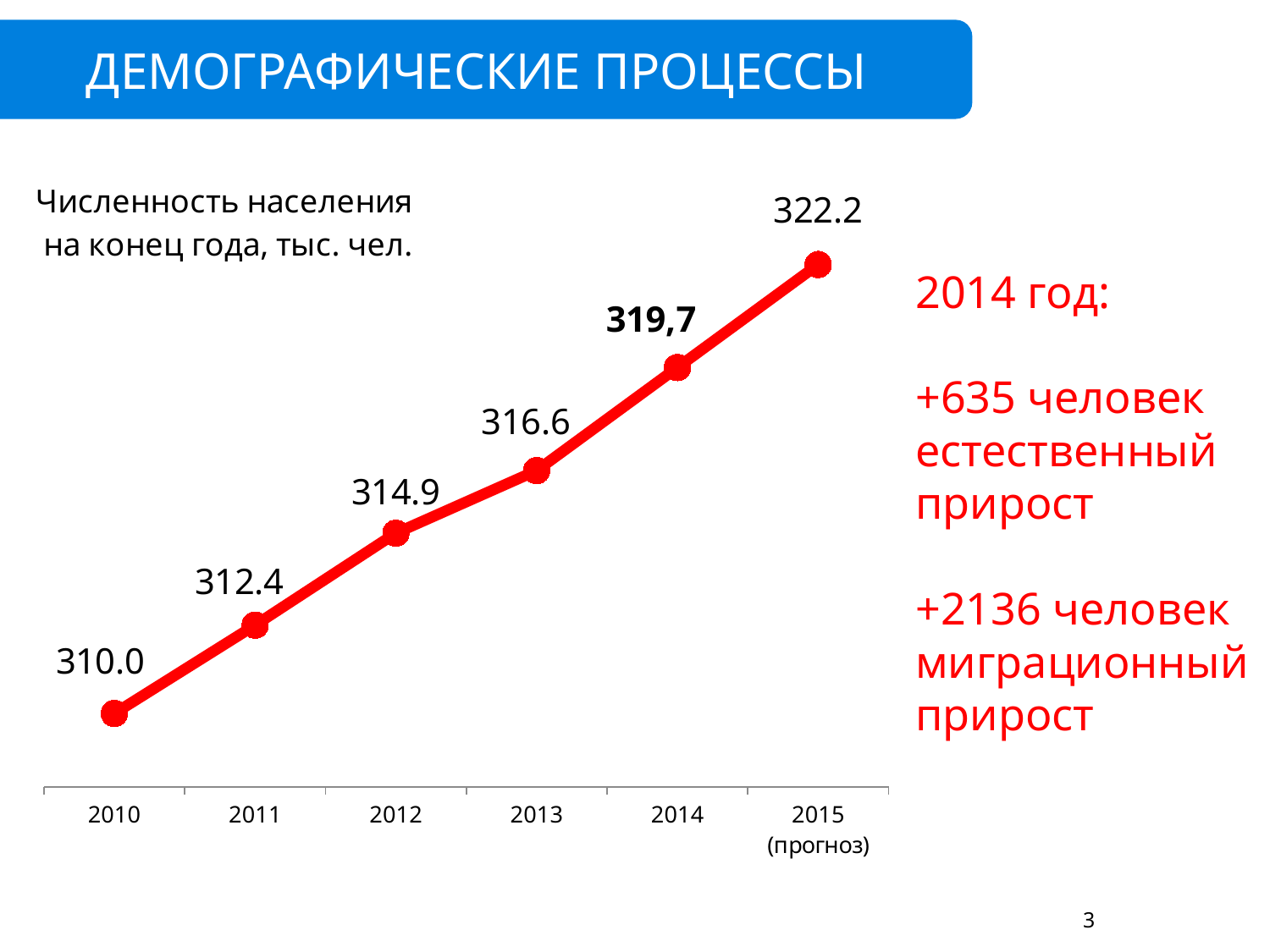
What is the population value shown for 2010? 310.0 Which year has the highest population value on the chart? 2015 (прогноз) What kind of chart is shown on the slide? line chart What is the forecast population value shown for 2015 (прогноз)? 322.2 Which is larger, the value for 2011 or the value for 2013? 2013 Which year has the lowest population value on the chart? 2010 Do the population values rise or fall from 2010 to 2015? rise What is the difference between the 2015 forecast value and the 2014 value? 2.5 What is the difference between the 2013 value and the 2012 value? 1.7 How many years (data points) are plotted on the chart? 6 What is the population value shown for 2012? 314.9 What is the population value shown for 2014? 319,7